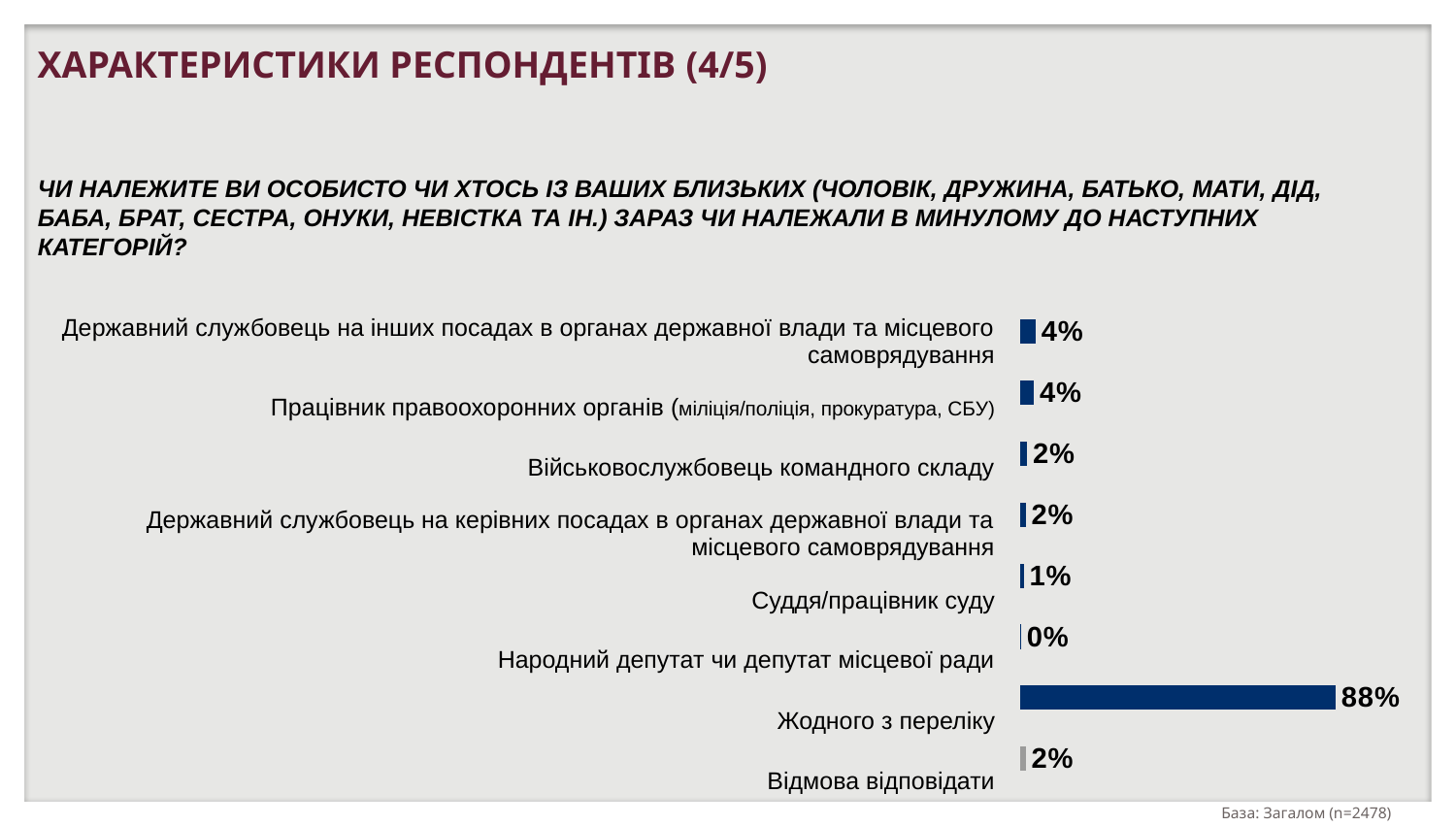
What type of chart is shown on the slide? bar chart What is the difference between the values for "Жодного з переліку" and "Працівник правоохоронних органів (міліція/поліція, прокуратура, СБУ)"? 84% Which is larger: the value for "Працівник правоохоронних органів (міліція/поліція, прокуратура, СБУ)" or the value for "Суддя/працівник суду"? Працівник правоохоронних органів (міліція/поліція, прокуратура, СБУ) What is the value for "Відмова відповідати"? 2% Which category has the lowest value? Народний депутат чи депутат місцевої ради What is the value for "Працівник правоохоронних органів (міліція/поліція, прокуратура, СБУ)"? 4% How many categories are plotted in the chart? 8 What is the value for "Військовослужбовець командного складу"? 2% Which category has the highest value? Жодного з переліку What is the value for "Народний депутат чи депутат місцевої ради"? 0% What is the value for "Жодного з переліку"? 88% What is the value for "Суддя/працівник суду"? 1%